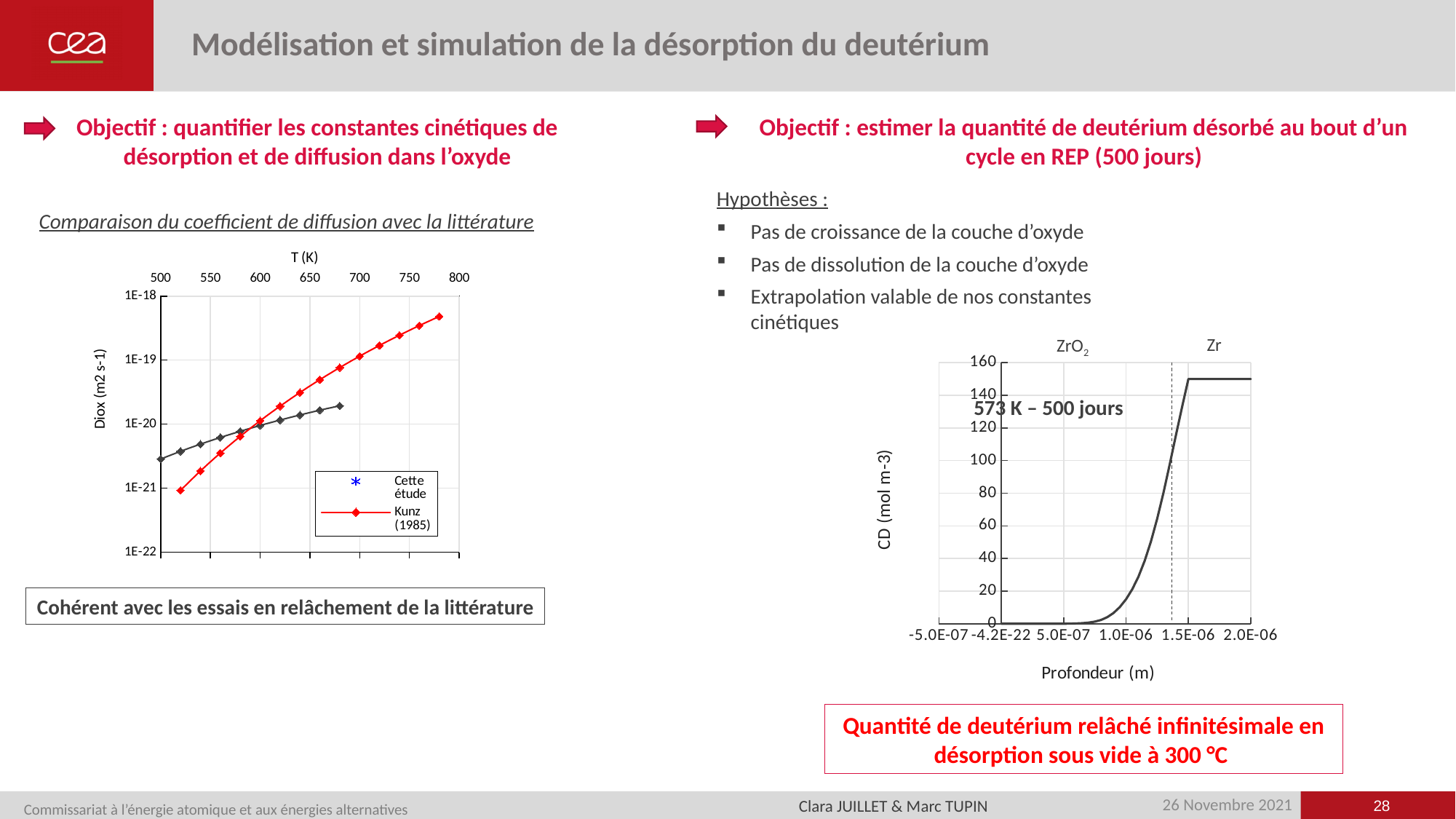
How many series does the legend of the left chart list? 2 What kind of chart is the left chart titled 'Comparaison du coefficient de diffusion avec la littérature'? line chart In the left chart, is the highest value of the Cette étude series greater or less than 1E-19? less In the left chart, what is the label of the y axis? Diox (m2 s-1) In the right chart, does CD rise or fall as Profondeur (m) increases from 5.0E-07 to 1.5E-06? rise In the left chart, do the values of the Kunz (1985) series rise or fall as T (K) increases? rise What are the two legend entries of the left chart? Cette étude and Kunz (1985) In the left chart, at 650 K, which series has the larger value, Cette étude or Kunz (1985)? Kunz (1985) What kind of chart is the right chart showing CD (mol m-3) versus Profondeur (m)? line chart In the left chart, at 500 K, which series has the larger value, Cette étude or Kunz (1985)? Cette étude In the left chart, is the highest value of the Kunz (1985) series greater or less than 1E-19? greater In the right chart, is the value of CD at a depth of 2.0E-06 m greater or less than 140? greater